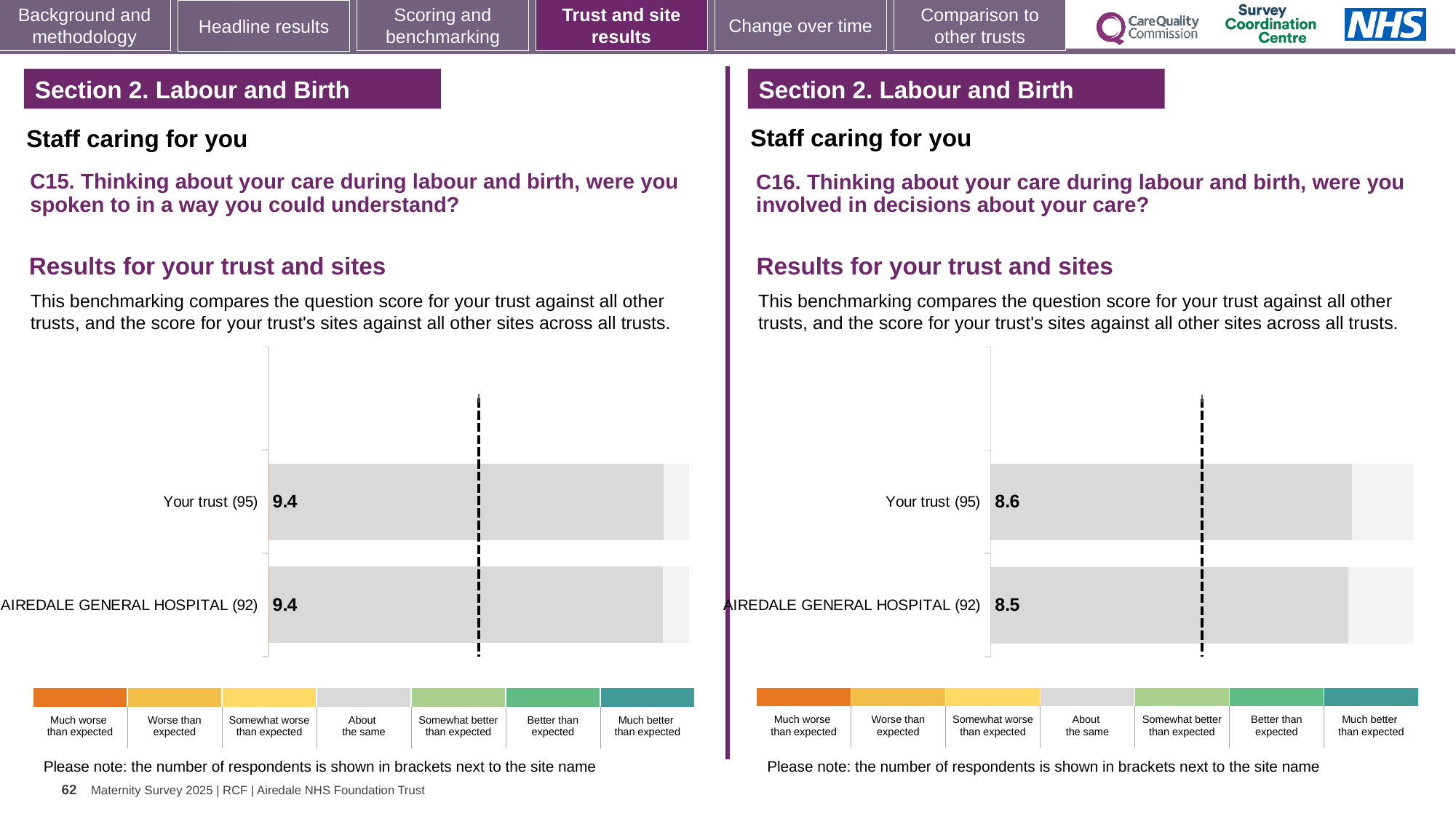
How many bars are plotted in the C15 chart on the left? 2 In the C15 chart on the left, what is the score for Your trust? 9.4 In the C15 chart on the left, how many respondents are shown in brackets for Airedale General Hospital? 92 In the C16 chart on the right, what is the difference between the Your trust score and the Airedale General Hospital score? 0.1 In the C16 chart on the right, what is the score for Airedale General Hospital? 8.5 In the C16 chart on the right, what is the score for Your trust? 8.6 In the C15 chart on the left, what is the score for Airedale General Hospital? 9.4 How many bars are plotted in the C16 chart on the right? 2 Which chart has the higher score for Your trust, the C15 chart on the left or the C16 chart on the right? C15 chart on the left In the C16 chart on the right, how many respondents are shown in brackets for Your trust? 95 What kind of chart is used for the C16 results on the right? Bar chart In the C15 chart on the left, what is the difference between the Your trust score and the Airedale General Hospital score? 0